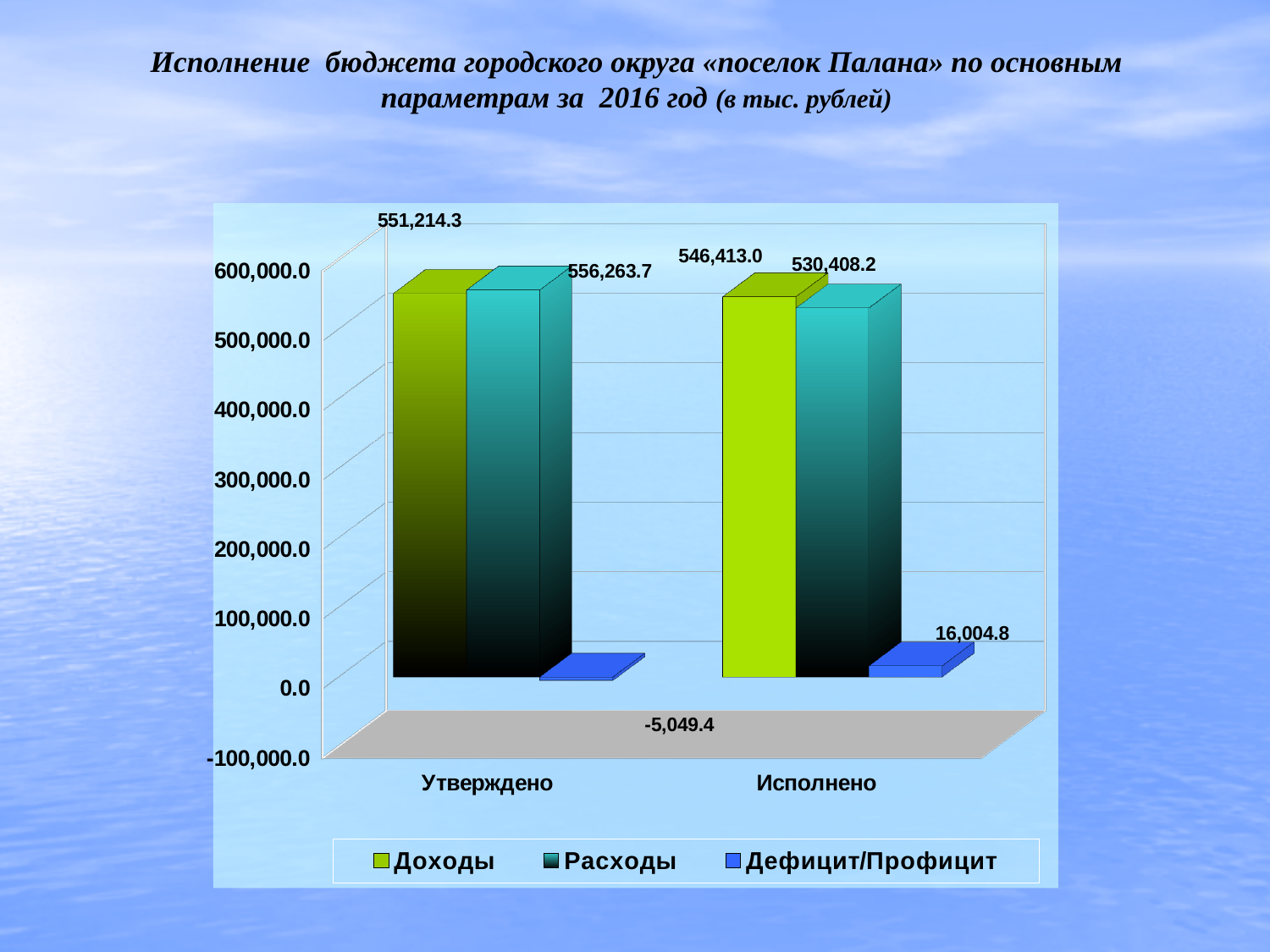
What is the difference between Доходы and Расходы for Исполнено? 16,004.8 What is the value of Расходы for Исполнено? 530,408.2 Which is larger for Исполнено: Доходы or Расходы? Доходы What is the value of Доходы for Исполнено? 546,413.0 What is the value of Доходы for Утверждено? 551,214.3 What is the value of Расходы for Утверждено? 556,263.7 How many categories are shown on the x axis? 2 What is the value of Дефицит/Профицит for Утверждено? -5,049.4 How many series does the legend list? 3 What is the value of Дефицит/Профицит for Исполнено? 16,004.8 What kind of chart is shown on the slide? Bar chart What is the difference between Расходы and Доходы for Утверждено? 5,049.4